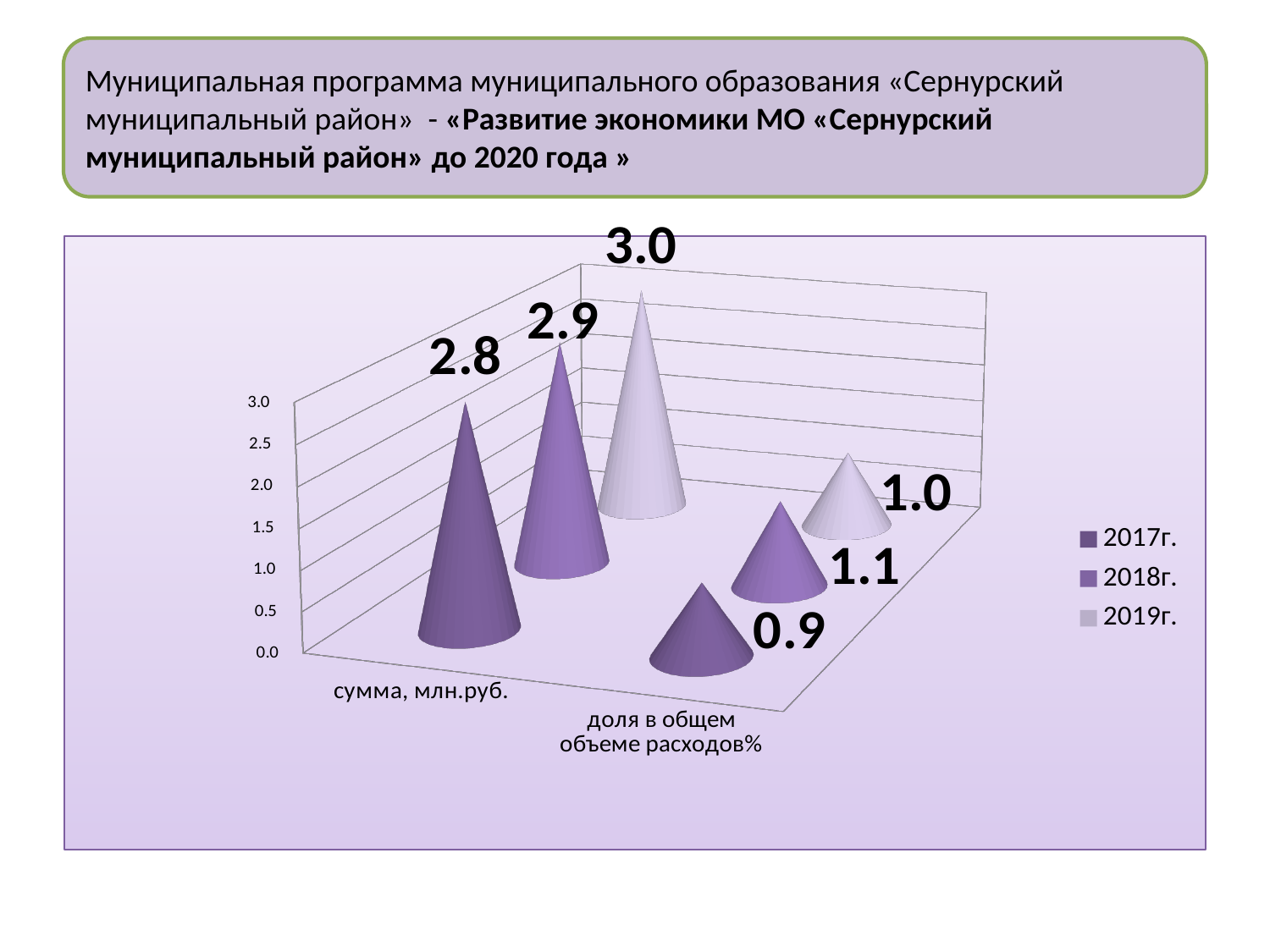
How many series does the legend list? 3 Which year has the lowest value in the category "доля в общем объеме расходов%"? 2017г. Which year has the highest value in the category "сумма, млн.руб."? 2019г. What is the difference between the 2019г. and 2017г. values in the category "сумма, млн.руб."? 0.2 Do the values for "сумма, млн.руб." rise or fall from 2017г. to 2019г.? rise How many categories are shown on the x axis? 2 What is the value for 2017г. in the category "сумма, млн.руб."? 2.8 What is the value for 2019г. in the category "сумма, млн.руб."? 3.0 What kind of chart is shown on the slide? 3D bar chart (cone-shaped bars) In the category "доля в общем объеме расходов%", which is larger: the value for 2018г. or for 2019г.? 2018г. What is the value for 2017г. in the category "доля в общем объеме расходов%"? 0.9 What is the value for 2018г. in the category "доля в общем объеме расходов%"? 1.1